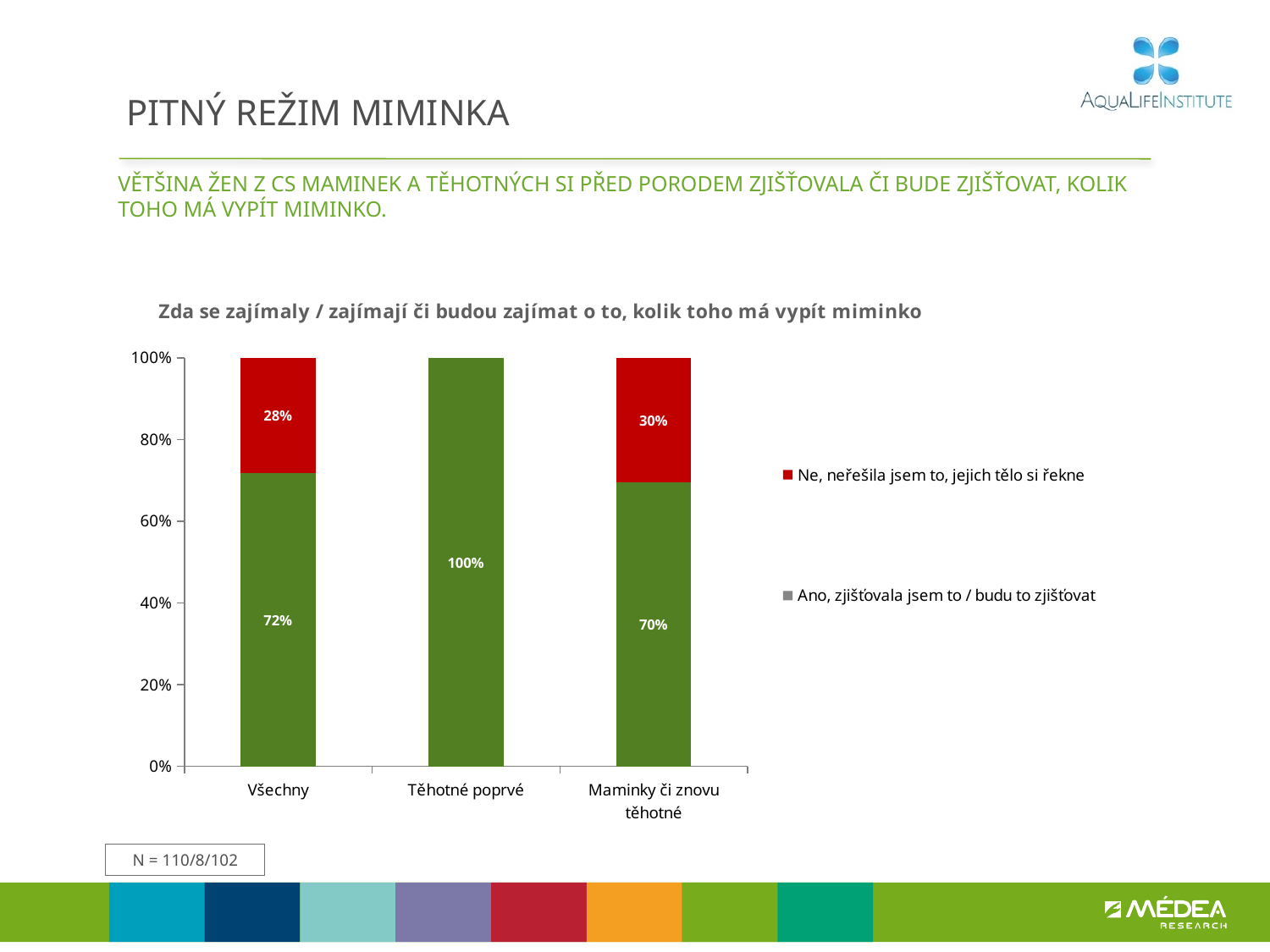
Which is larger: the 'Ne, neřešila jsem to, jejich tělo si řekne' value for 'Všechny' or for 'Maminky či znovu těhotné'? Maminky či znovu těhotné How many series does the chart legend list? 2 What is the value for 'Ne, neřešila jsem to, jejich tělo si řekne' in the 'Maminky či znovu těhotné' category? 30% Which category has the highest value for 'Ano, zjišťovala jsem to / budu to zjišťovat'? Těhotné poprvé How many categories are shown on the x axis of the chart? 3 What is the difference between the 'Ano, zjišťovala jsem to / budu to zjišťovat' values for 'Všechny' and 'Maminky či znovu těhotné'? 2% What is the value for 'Ano, zjišťovala jsem to / budu to zjišťovat' in the 'Těhotné poprvé' category? 100% What is the title of the chart? Zda se zajímaly / zajímají či budou zajímat o to, kolik toho má vypít miminko What is the value for 'Ano, zjišťovala jsem to / budu to zjišťovat' in the 'Všechny' category? 72% What kind of chart is shown on the slide? Stacked bar chart Which category has the lowest value for 'Ano, zjišťovala jsem to / budu to zjišťovat'? Maminky či znovu těhotné What is the value for 'Ne, neřešila jsem to, jejich tělo si řekne' in the 'Všechny' category? 28%